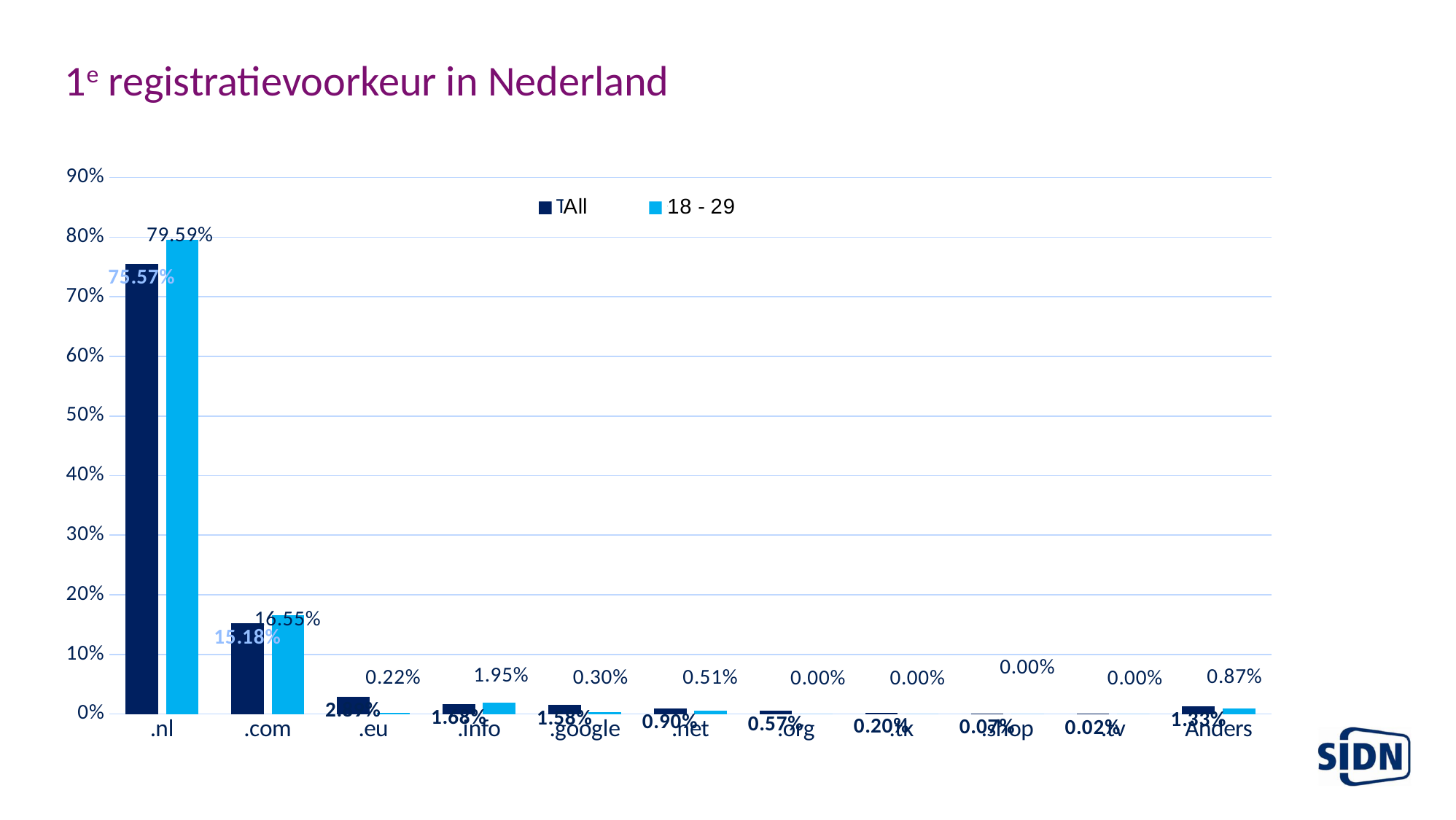
What is the difference between the 18 - 29 value and the All value for .nl? 4.02% Is the All value for .nl greater or less than 70%? greater How many categories are shown on the x axis? 11 What is the value for .info in the 18 - 29 series? 1.95% What is the value for .org in the 18 - 29 series? 0.00% For .com, which series has the larger value, All or 18 - 29? 18 - 29 How many series does the legend list? 2 What kind of chart is shown on the slide? bar chart What is the title of the slide? 1e registratievoorkeur in Nederland Which category has the highest value in the All series? .nl What is the value for .com in the All series? 15.18% What is the value for .nl in the 18 - 29 series? 79.59%